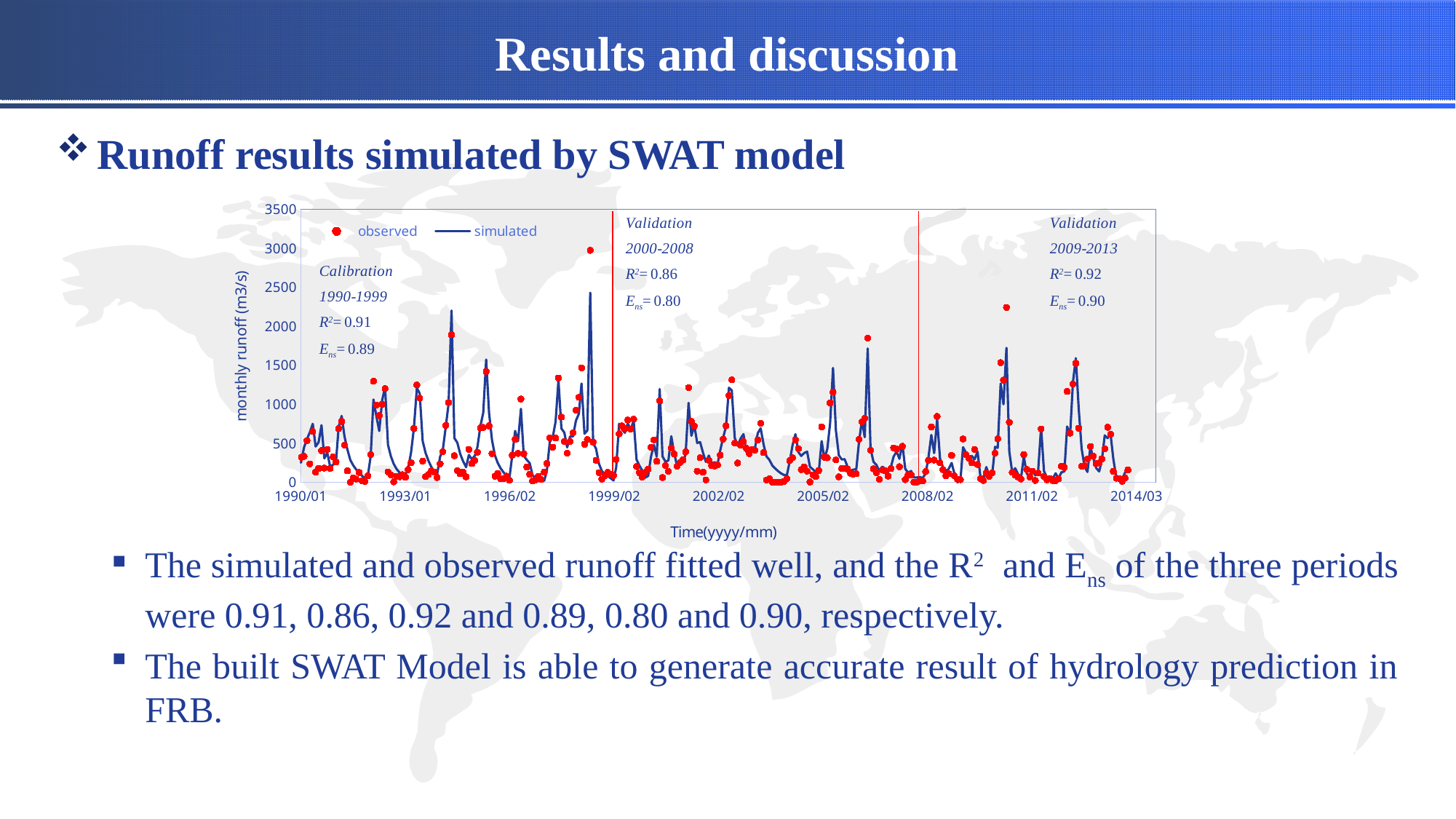
What is the difference between the R² of the Calibration period and the R² of the Validation 2000-2008 period? 0.05 What is the R² value printed for the Validation period 2009-2013? 0.92 How many series does the chart legend list? 2 What is the label of the y axis of the chart? monthly runoff (m3/s) Which period has the lowest Ens value printed on the chart? Validation 2000-2008 What kind of chart is used to show the monthly runoff? line chart with scatter points What is the Ens value printed for the Validation period 2000-2008? 0.80 Is the highest observed runoff value on the chart greater or less than 2500? greater Which period has the highest R² value printed on the chart? Validation 2009-2013 What is the R² value printed for the Calibration period 1990-1999? 0.91 What is the maximum value shown on the y axis of the chart? 3500 What are the two series named in the chart legend? observed and simulated